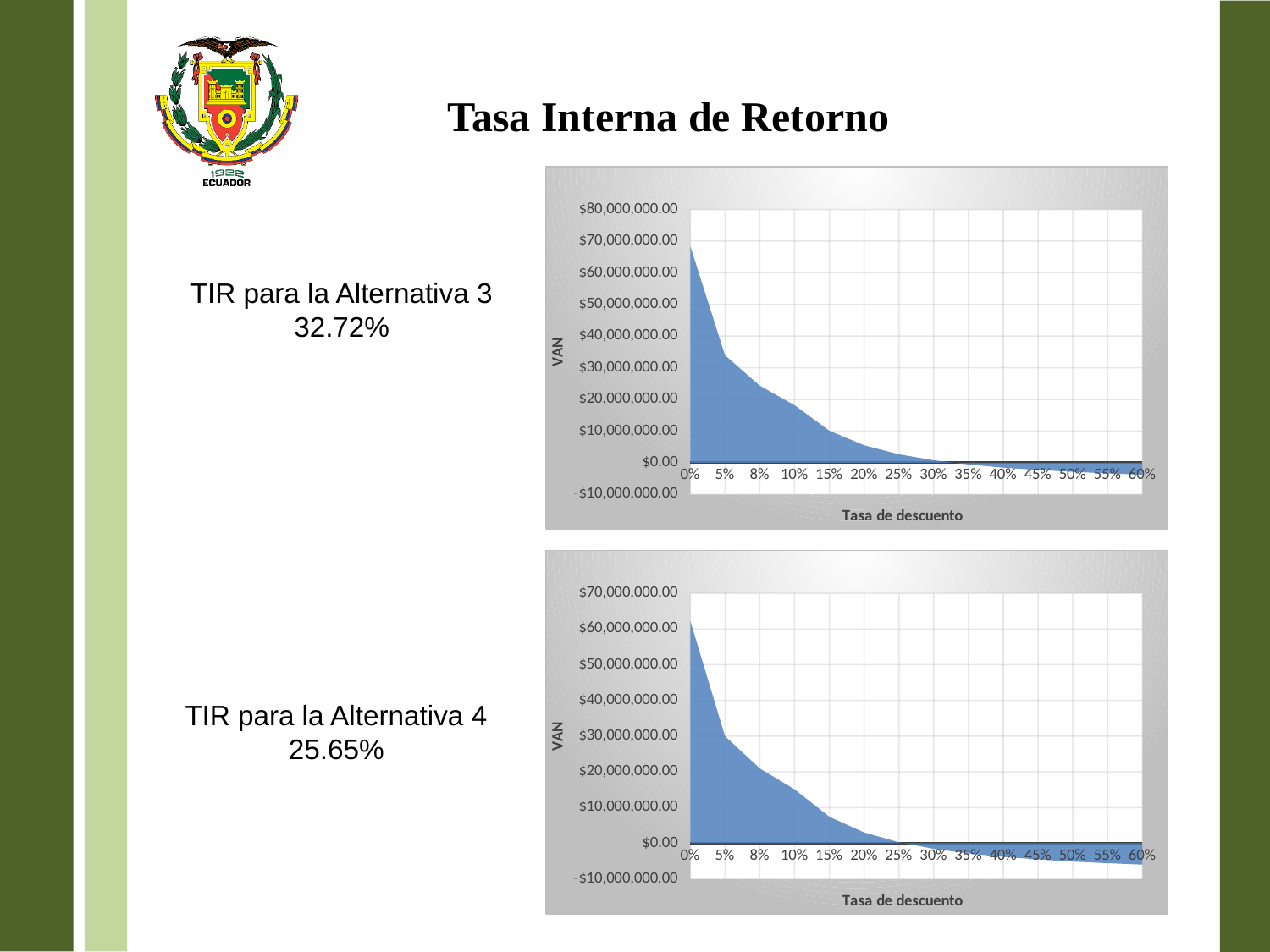
In the top chart, what is the label of the vertical axis? VAN In the bottom chart, is the VAN at 0% greater or less than $50,000,000.00? greater In the bottom chart, does the VAN rise or fall as the discount rate increases along the x axis? fall In the bottom chart, is the VAN at 5% greater or less than $40,000,000.00? less In the top chart, is the VAN at 0% greater or less than $60,000,000.00? greater In the bottom chart, what is the label of the horizontal axis? Tasa de descuento How many discount-rate categories are shown on the x axis of the top chart? 14 In the top chart, does the VAN rise or fall as the discount rate increases along the x axis? fall In the top chart, at which discount rate is the VAN highest? 0% In the top chart, which has the larger VAN: the 0% discount rate or the 60% discount rate? 0% In the bottom chart, at which discount rate is the VAN lowest? 60% What kind of chart is the top chart on the slide? area chart